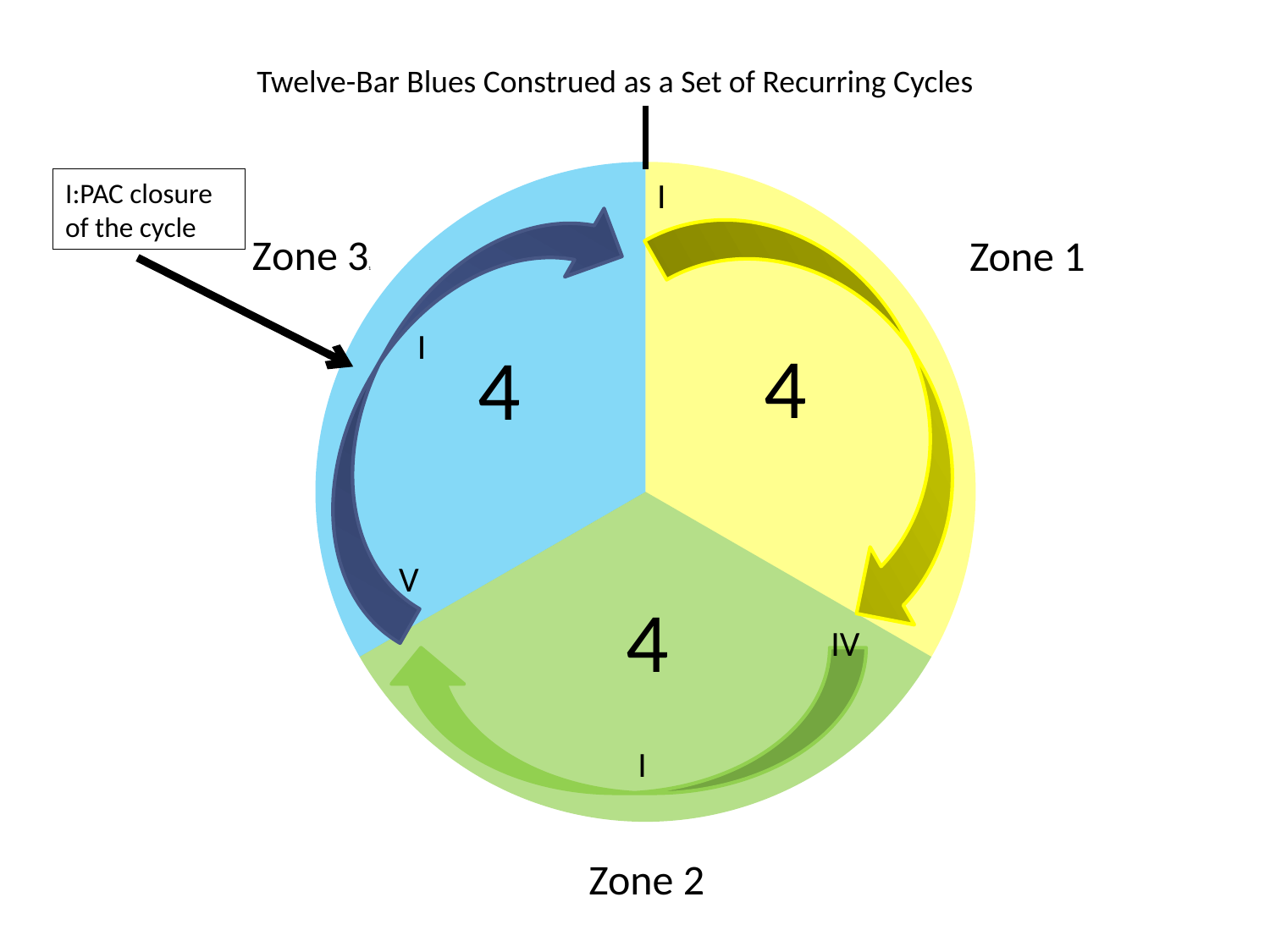
What is the total of the values printed in all three slices? 12 What value is printed in the Zone 3 slice? 4 What is the difference between the values for Zone 1 and Zone 3? 0 What value is printed in the Zone 1 slice? 4 What colour is the Zone 1 slice? yellow What kind of chart is shown on the slide? pie chart What is the title of the chart? Twelve-Bar Blues Construed as a Set of Recurring Cycles Is the value for Zone 1 larger than, smaller than, or equal to the value for Zone 2? equal How many slices (zones) does the pie chart have? 3 What share of the whole pie does Zone 2 represent? one third What value is printed in the Zone 2 slice? 4